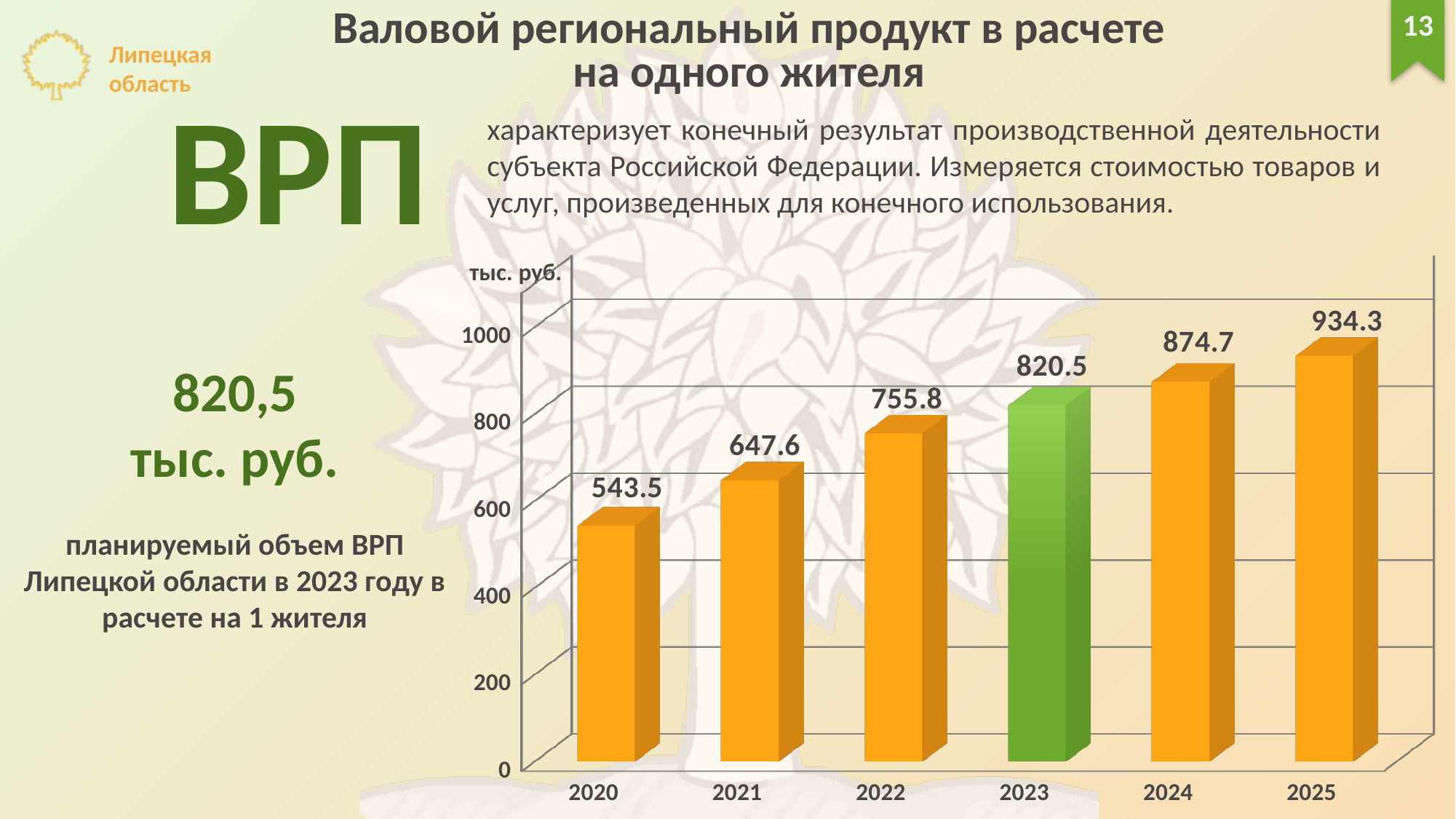
What is the difference between the values for 2025 and 2020? 390.8 What is the value for 2023? 820.5 Do the values rise or fall from 2020 to 2025? rise What is the value for 2020? 543.5 What is the value for 2025? 934.3 Is the value for 2021 greater or less than 600? greater What kind of chart is shown on the slide? bar chart What is the difference between the values for 2022 and 2021? 108.2 Which year has the highest value? 2025 Which is larger, the value for 2024 or the value for 2022? 2024 Which year has the lowest value? 2020 How many years are shown on the x axis? 6